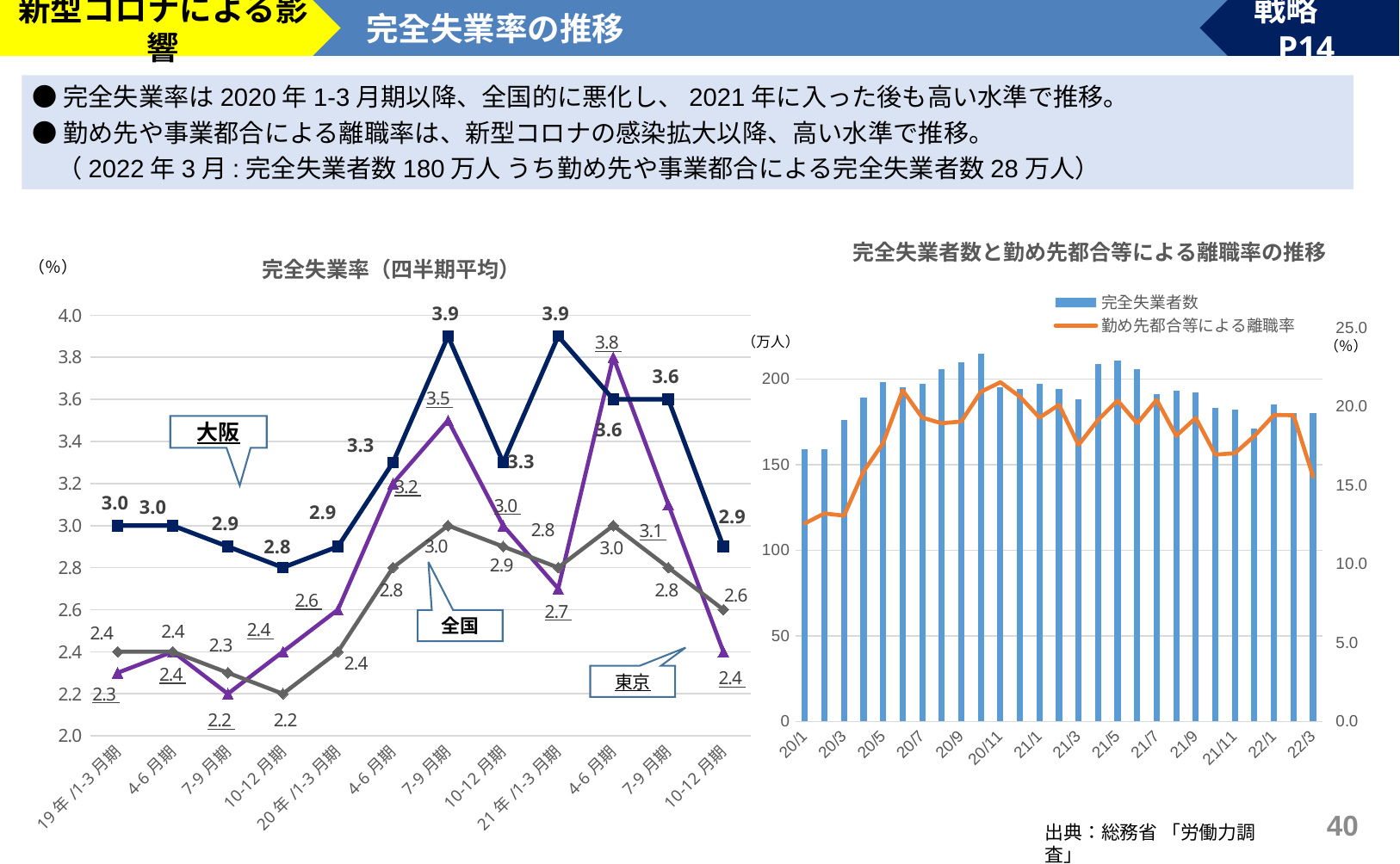
In the left chart 完全失業率（四半期平均）, what is the value for 大阪 in 20年/7-9月期? 3.9 In the left chart 完全失業率（四半期平均）, what is the value for 全国 in 20年/10-12月期? 2.9 In the left chart 完全失業率（四半期平均）, does the 大阪 line rise or fall from 19年/1-3月期 to 19年/10-12月期? fall In the left chart 完全失業率（四半期平均）, how many quarters are plotted on the x axis? 12 In the right chart 完全失業者数と勤め先都合等による離職率の推移, how many series does the legend list? 2 In the left chart 完全失業率（四半期平均）, how many series are plotted? 3 In the left chart 完全失業率（四半期平均）, what is the difference between 大阪 and 全国 in 20年/7-9月期? 0.9 In the left chart 完全失業率（四半期平均）, in which quarter does 全国 reach its lowest value? 19年/10-12月期 In the left chart 完全失業率（四半期平均）, what is the highest value reached by 大阪? 3.9 In the left chart 完全失業率（四半期平均）, what is the value for 東京 in 21年/4-6月期? 3.8 In the left chart 完全失業率（四半期平均）, which is higher in 21年/4-6月期, 東京 or 全国? 東京